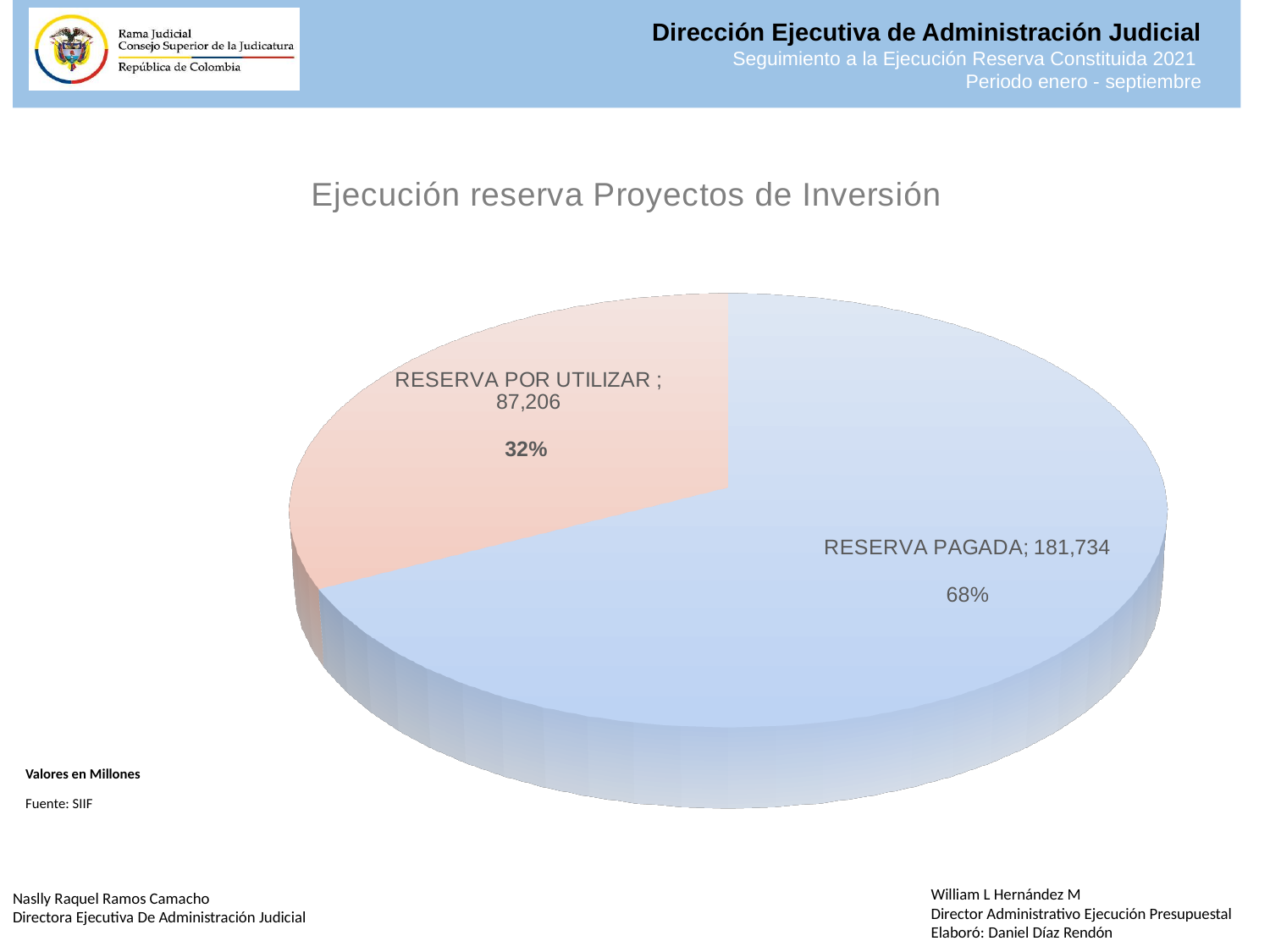
What is the value for RESERVA PAGADA? 181,734 Which slice is the smallest in the pie chart? RESERVA POR UTILIZAR What is the title of the chart? Ejecución reserva Proyectos de Inversión Which is larger, RESERVA PAGADA or RESERVA POR UTILIZAR? RESERVA PAGADA What is the total of RESERVA PAGADA and RESERVA POR UTILIZAR? 268,940 What is the difference between RESERVA PAGADA and RESERVA POR UTILIZAR? 94,528 How many slices does the pie chart have? 2 What kind of chart is shown on the slide? Pie chart Which slice is the largest in the pie chart? RESERVA PAGADA What is the value for RESERVA POR UTILIZAR? 87,206 What share of the pie does RESERVA PAGADA represent? 68% What share of the pie does RESERVA POR UTILIZAR represent? 32%